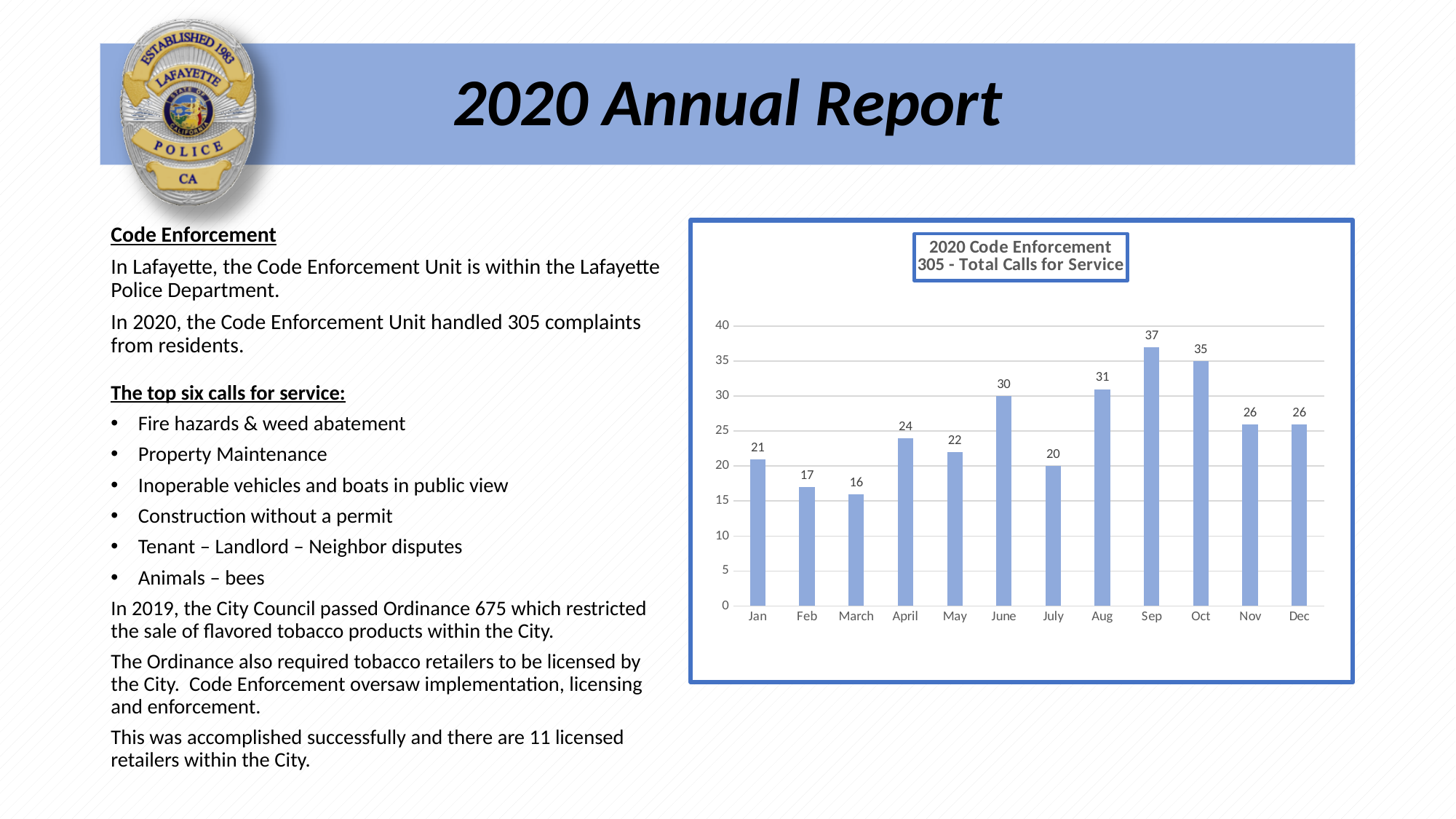
Which is larger, the value for April or the value for May? April What is the difference between the values for Aug and Feb? 14 What is the title of the chart? 2020 Code Enforcement 305 - Total Calls for Service Which month has the lowest value in the chart? March How many months are shown on the x axis of the chart? 12 Is the value for Oct greater or less than 30? greater Which month has the highest value in the chart? Sep What is the value for March in the chart? 16 What kind of chart is shown on the slide? bar chart What is the value for June in the chart? 30 What is the difference between the values for Sep and Oct? 2 What is the value for Sep in the chart? 37